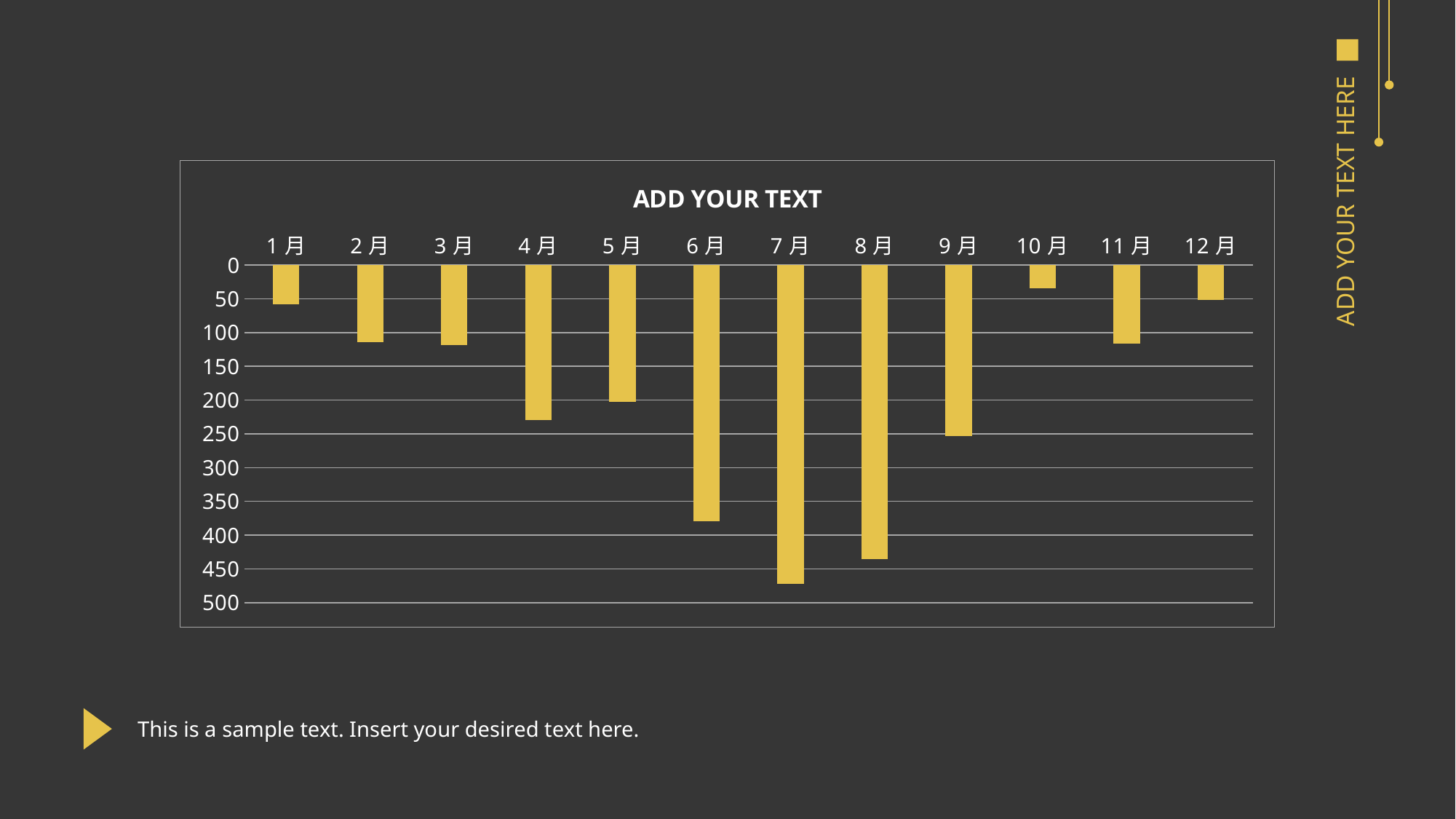
Is the value for 7月 greater or less than 450? greater Is the value for 1月 greater or less than 100? less What is the title of the chart? ADD YOUR TEXT How many categories (months) are plotted on the x axis? 12 Which has the larger value, 10月 or 11月? 11月 Which has the larger value, 6月 or 8月? 8月 Is the value for 3月 greater or less than 150? less Which month has the lowest value (shortest bar)? 10月 What kind of chart is shown on the slide? bar chart Which month has the highest value (longest bar)? 7月